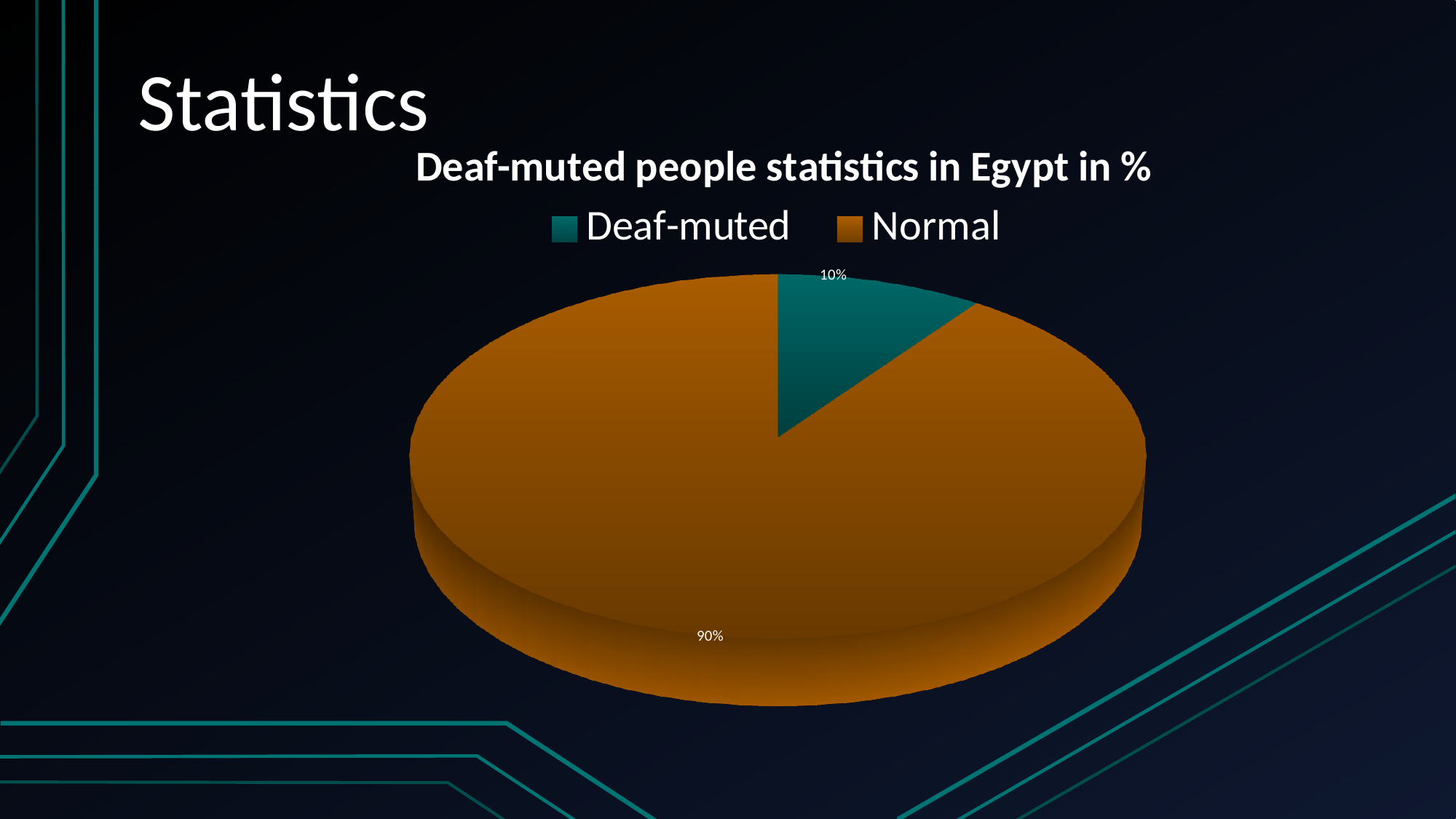
What is the value shown for the Deaf-muted slice? 10% What is the title of the chart? Deaf-muted people statistics in Egypt in % What is the difference between the Normal and Deaf-muted values? 80% What kind of chart is shown on the slide? pie chart How many entries does the legend list? 2 What is the value shown for the Normal slice? 90% What colour is the Normal slice? orange Which is larger, the Deaf-muted slice or the Normal slice? Normal How many slices does the pie chart have? 2 Which slice is the smallest? Deaf-muted What share of the pie does the Deaf-muted slice represent? 10% Which slice is the largest? Normal